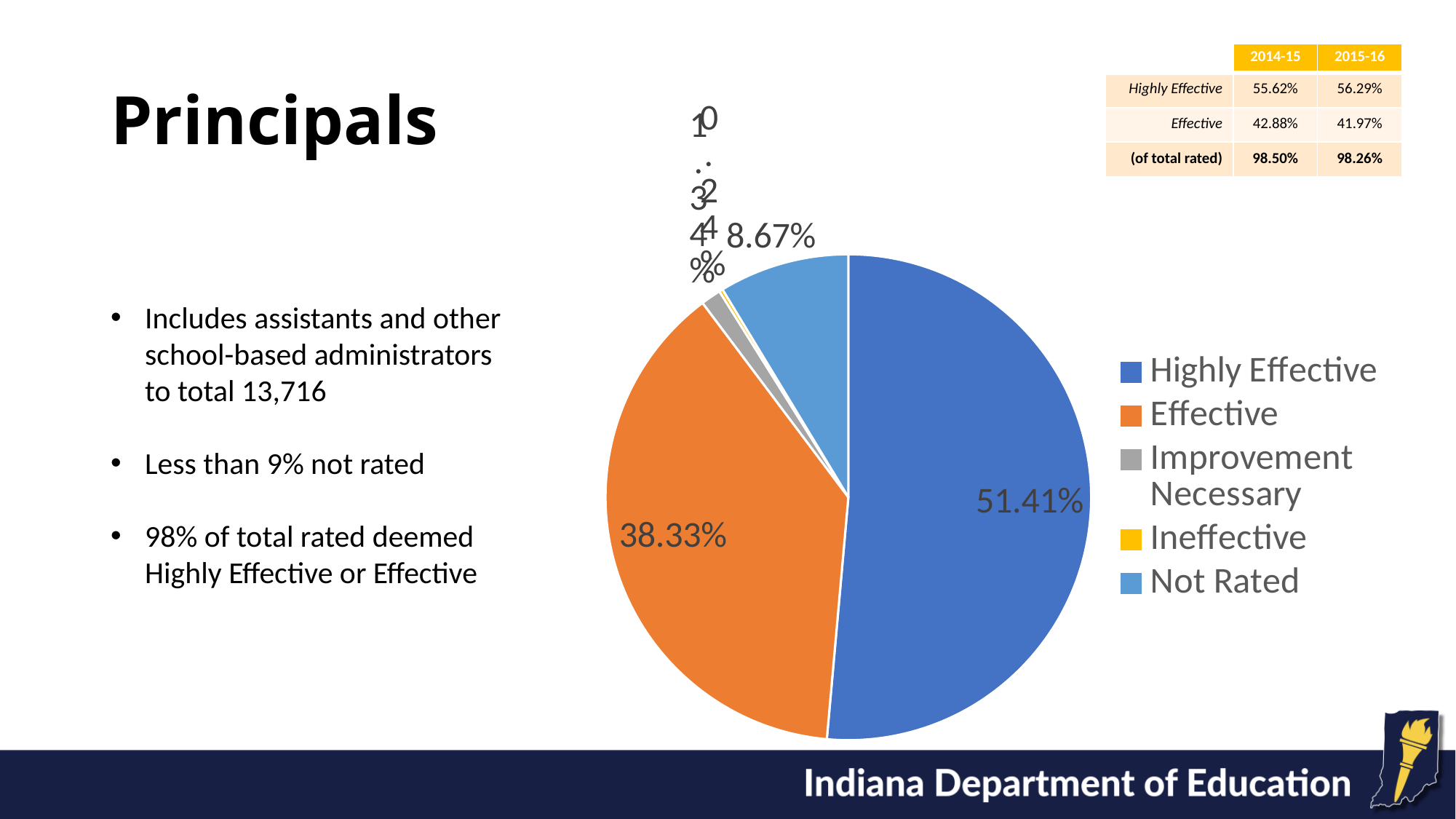
Which slice of the pie chart is larger, Highly Effective or Effective? Highly Effective What percentage of the pie chart is labelled for Highly Effective? 51.41% What percentage of the pie chart is labelled for Not Rated? 8.67% What kind of chart is shown on the slide? pie chart How many categories does the pie chart's legend list? 5 What colour is the Not Rated slice in the pie chart? light blue What is the difference between the Effective and Not Rated slices of the pie chart? 29.66% What percentage of the pie chart is labelled for Effective? 38.33% Which category has the largest slice of the pie chart? Highly Effective What is the difference between the Highly Effective and Effective slices of the pie chart? 13.08% Which slice of the pie chart is larger, Effective or Not Rated? Effective What is the combined share of the Highly Effective and Effective slices in the pie chart? 89.74%